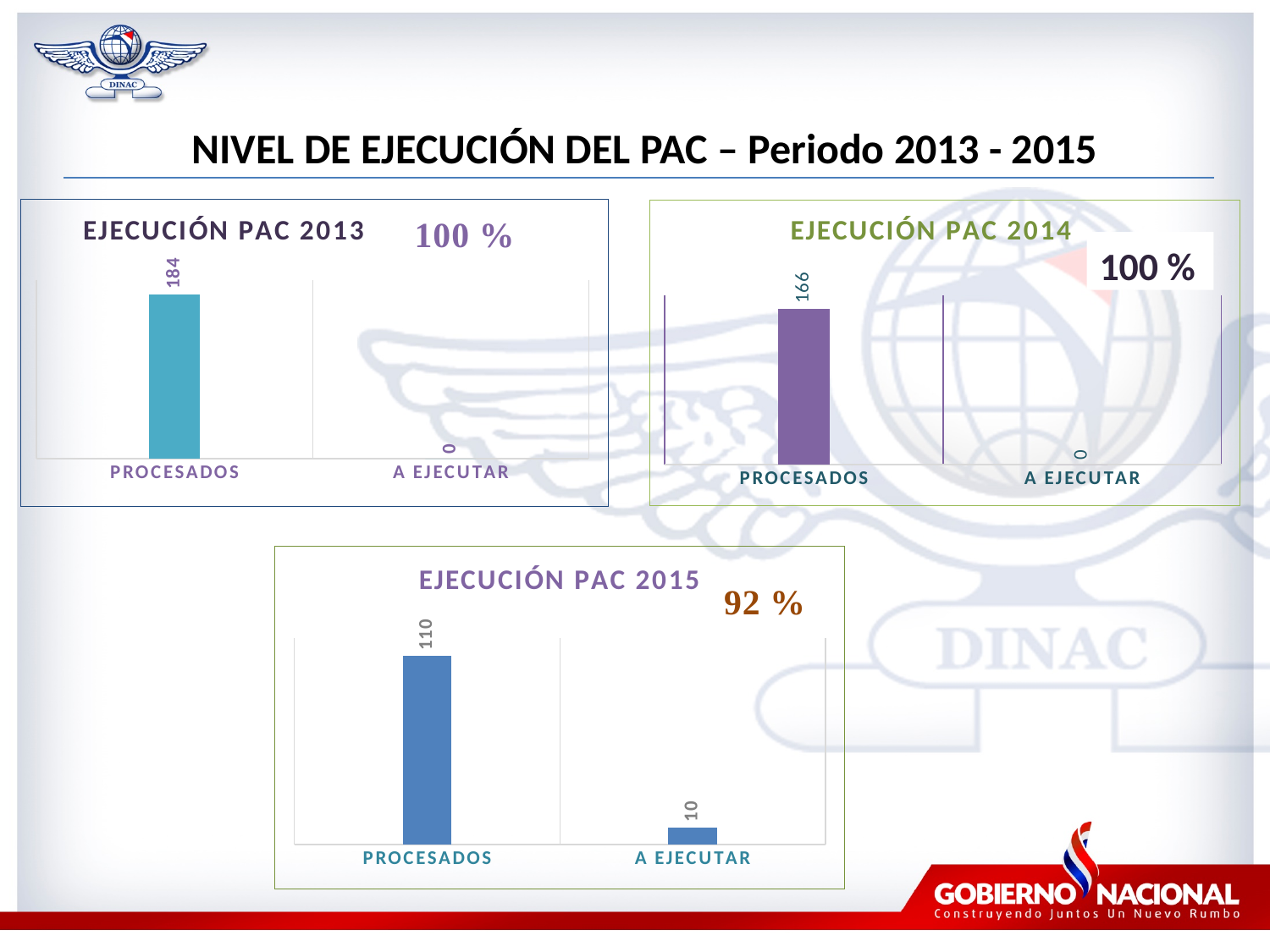
In the EJECUCIÓN PAC 2013 chart, what is the value for A EJECUTAR? 0 What kind of chart is the EJECUCIÓN PAC 2014 chart? Bar chart In the EJECUCIÓN PAC 2015 chart, which category has the highest value? PROCESADOS In the EJECUCIÓN PAC 2015 chart, what is the value for PROCESADOS? 110 In the EJECUCIÓN PAC 2015 chart, what is the value for A EJECUTAR? 10 In the EJECUCIÓN PAC 2015 chart, what is the difference between PROCESADOS and A EJECUTAR? 100 How many categories does the EJECUCIÓN PAC 2015 chart show? 2 In the EJECUCIÓN PAC 2014 chart, which category has the lowest value? A EJECUTAR What percentage is shown next to the EJECUCIÓN PAC 2015 chart? 92 % Which is larger: PROCESADOS in the EJECUCIÓN PAC 2013 chart or PROCESADOS in the EJECUCIÓN PAC 2014 chart? PROCESADOS in EJECUCIÓN PAC 2013 In the EJECUCIÓN PAC 2013 chart, what is the value for PROCESADOS? 184 In the EJECUCIÓN PAC 2014 chart, what is the value for PROCESADOS? 166